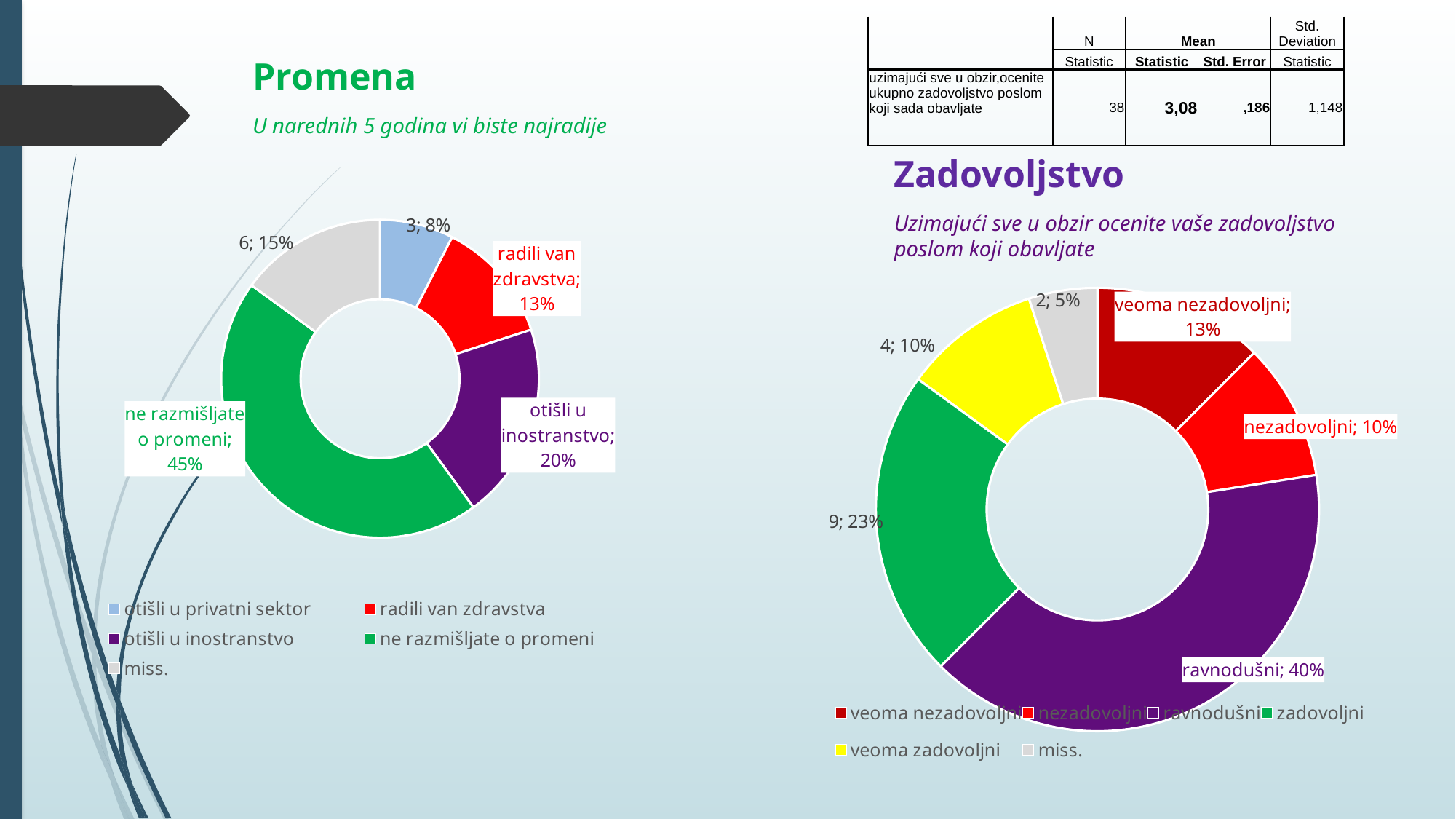
In the Zadovoljstvo chart, which is larger: 'veoma nezadovoljni' or 'nezadovoljni'? veoma nezadovoljni In the Promena chart, which category has the largest slice? ne razmišljate o promeni In the Promena chart, what share is labelled for 'ne razmišljate o promeni'? 45% In the Zadovoljstvo chart, what is the difference in percentage points between 'ravnodušni' and 'zadovoljni'? 17 In the Zadovoljstvo chart, which category has the smallest slice? miss. What type of chart is the Zadovoljstvo chart? doughnut (pie) chart In the Promena chart, what count and share are labelled for the 'miss.' slice? 6; 15% In the Zadovoljstvo chart, what count and share are labelled for the 'zadovoljni' slice? 9; 23% In the Promena chart, which category has the smallest slice? otišli u privatni sektor In the Zadovoljstvo chart, what share is labelled for 'ravnodušni'? 40% In the Promena chart, how many categories does the legend list? 5 In the Promena chart, what share is labelled for 'otišli u inostranstvo'? 20%